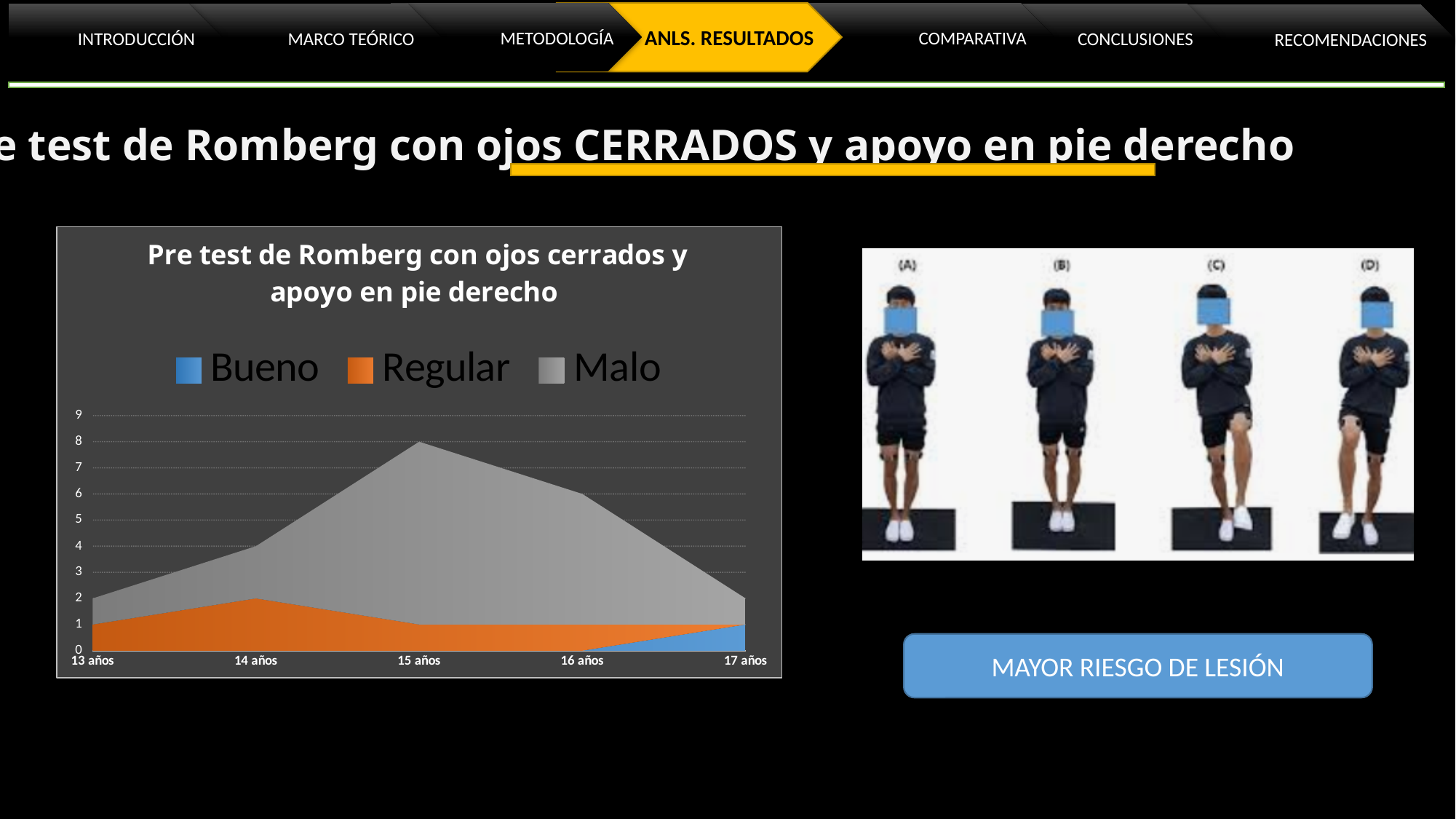
Does the top of the stacked area rise or fall from 15 años to 17 años? fall Is the top of the stacked area at 17 años greater or less than 4? less Which series are listed in the chart legend? Bueno, Regular, Malo What is the title of the chart? Pre test de Romberg con ojos cerrados y apoyo en pie derecho What kind of chart is shown on the slide? Area chart Does the top of the stacked area rise or fall from 13 años to 15 años? rise Is the top of the stacked area at 13 años greater or less than 3? less How many series does the chart legend list? 3 Which is larger: the top of the stacked area at 15 años or at 16 años? 15 años How many age categories are shown along the x axis of the chart? 5 At which age category does the stacked area reach its highest point? 15 años Is the top of the stacked area at 15 años greater or less than 7? greater